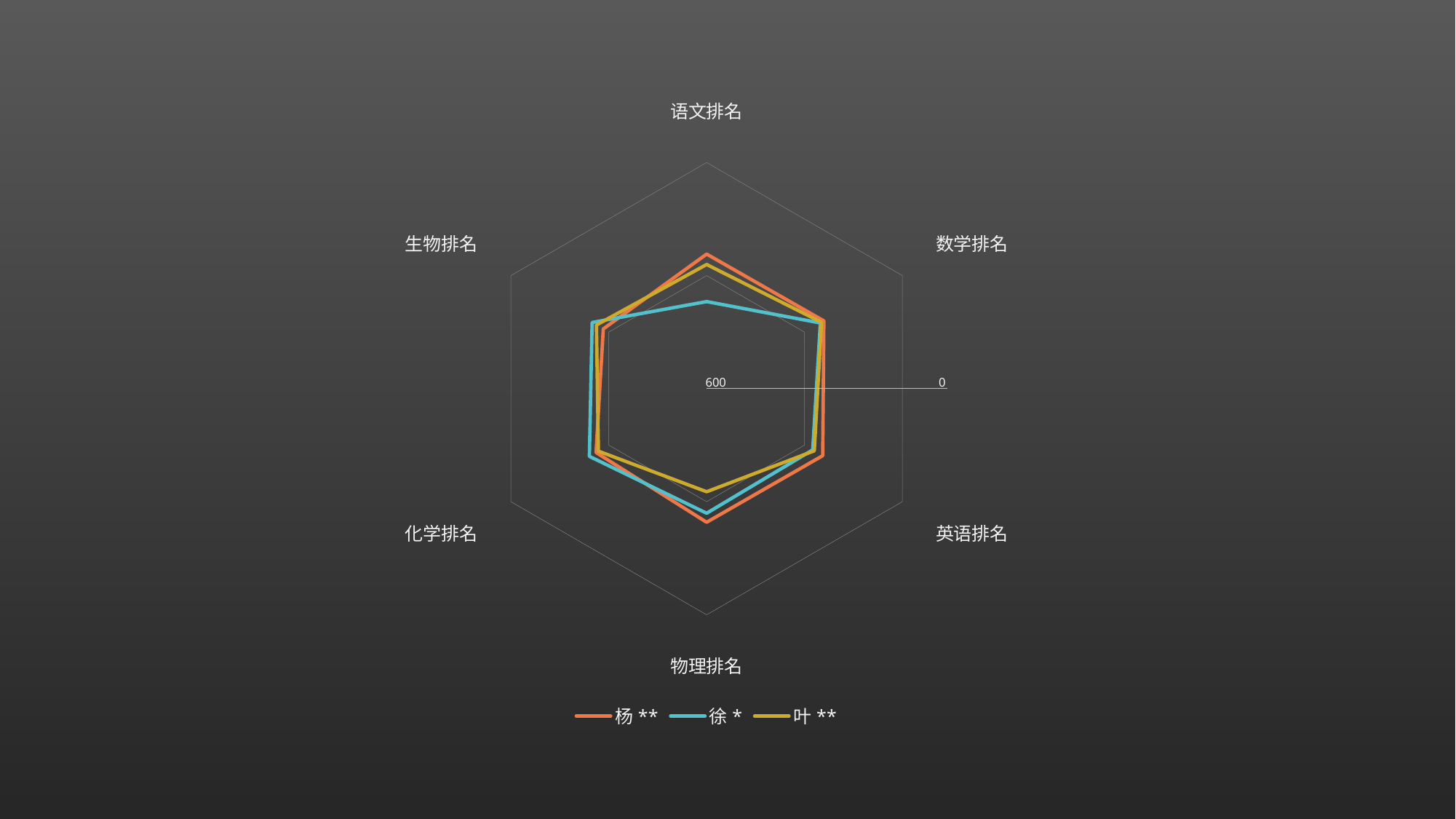
On the 语文排名 axis, which series' point lies closest to the centre of the chart? 徐 * What value is labelled at the centre of the radar chart? 600 On the 化学排名 axis, which series' point lies farthest from the centre of the chart? 徐 * Which category label appears at the bottom of the radar chart? 物理排名 What kind of chart is shown on the slide? radar chart Which series are listed in the legend? 杨 **, 徐 *, 叶 ** On the 语文排名 axis, which series' point lies farthest from the centre of the chart? 杨 ** How many series does the legend list? 3 How many axes (categories) does the radar chart have? 6 Which category label appears at the top of the radar chart? 语文排名